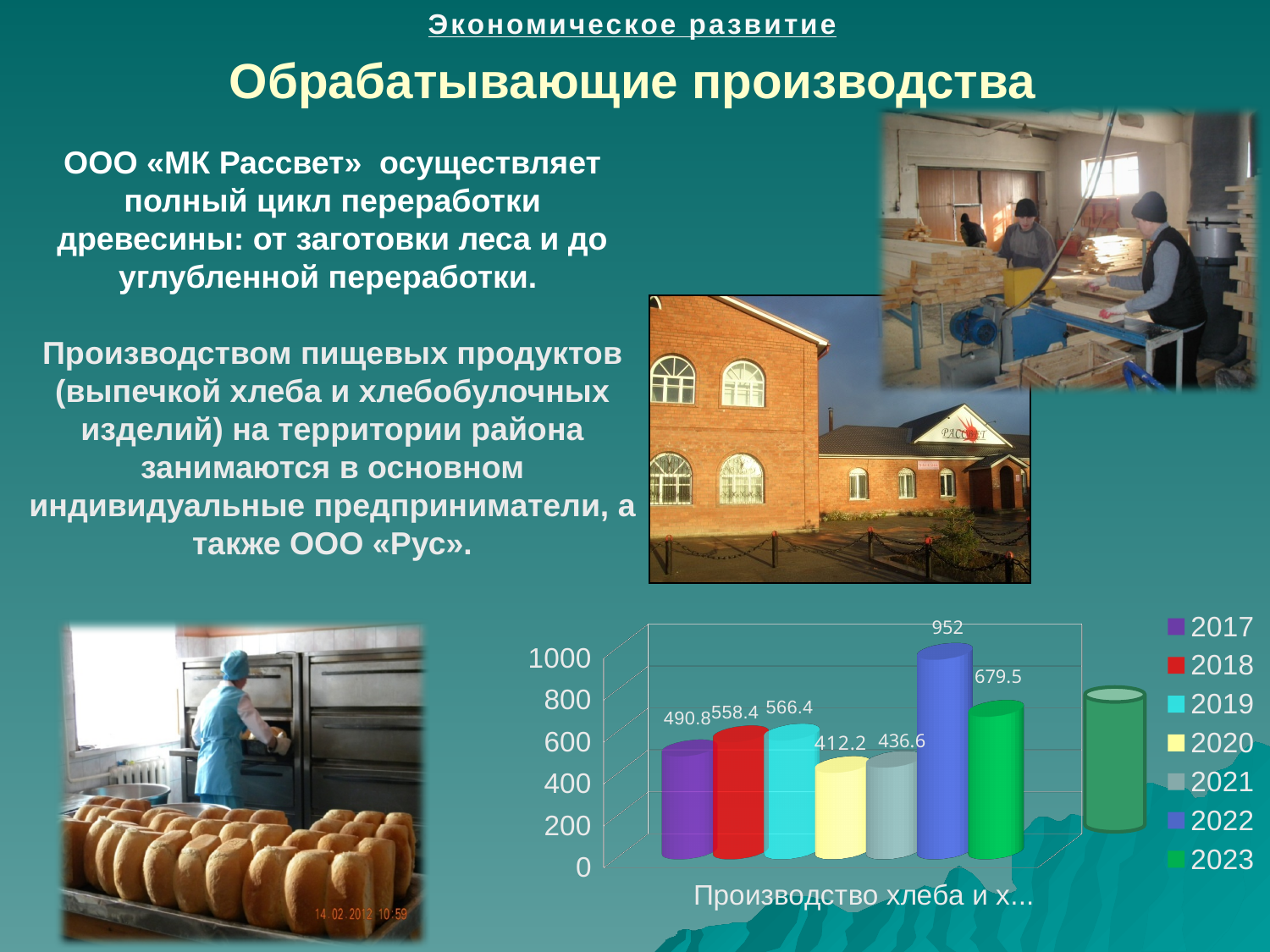
Which year has the lowest value in the chart? 2020 What colour is the bar for 2018 in the chart? red How many series does the legend list? 7 What is the value for 2020 in the chart? 412.2 Which year has the highest value in the chart? 2022 What is the difference between the values for 2022 and 2023? 272.5 What is the value for 2022 in the chart? 952 What is the difference between the values for 2018 and 2017? 67.6 What is the value for 2023 in the chart? 679.5 Which is larger, the value for 2019 or the value for 2021? 2019 What kind of chart is shown on the slide? bar chart What is the value for 2017 in the chart? 490.8